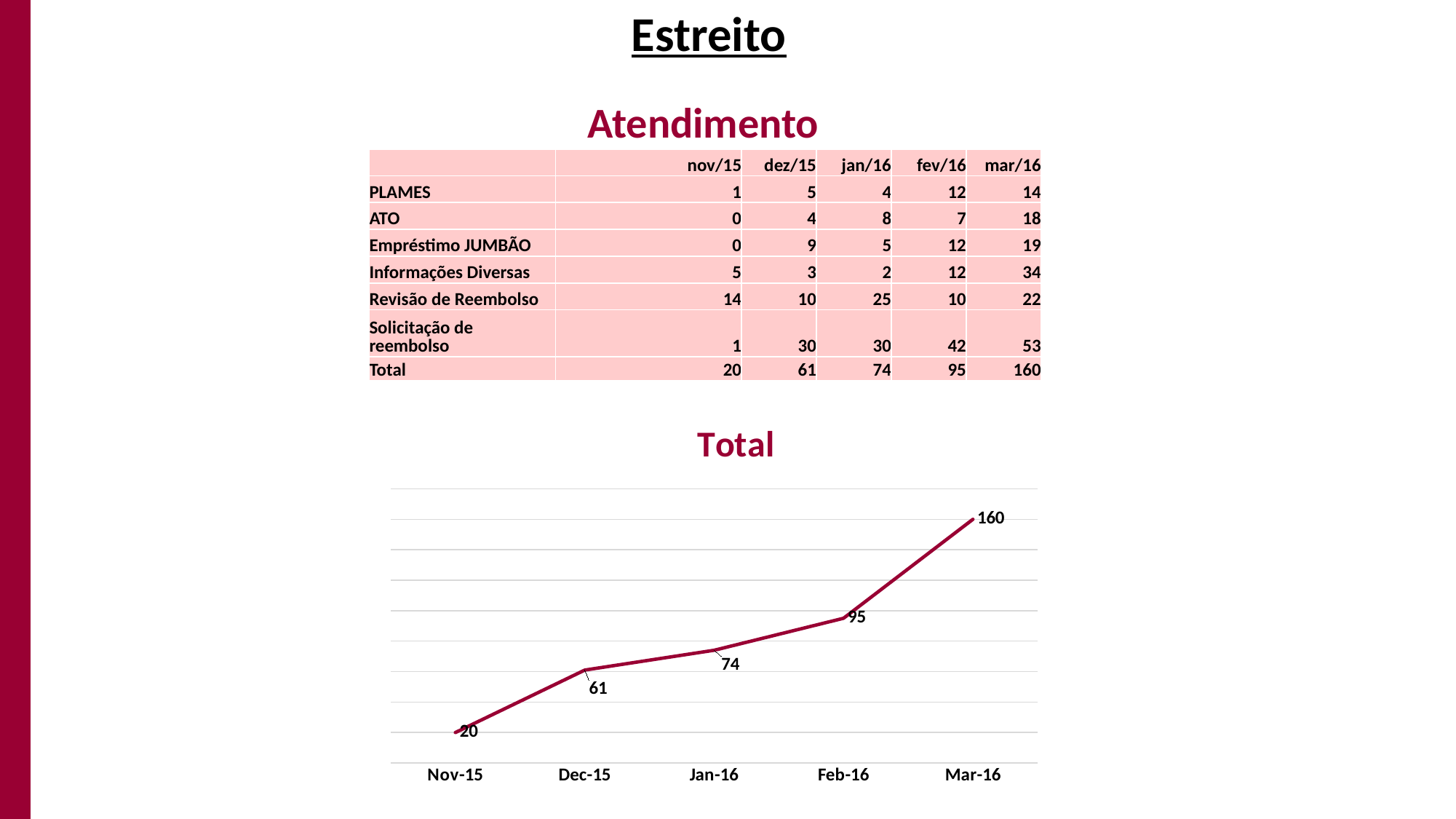
Do the values in the Total chart rise or fall from Nov-15 to Mar-16? rise Which is larger in the Total chart, the value for Feb-16 or the value for Jan-16? Feb-16 What is the value for Mar-16 in the Total chart? 160 What kind of chart is the Total chart? line chart How many data points are plotted in the Total chart? 5 What is the difference between the Dec-15 and Nov-15 values in the Total chart? 41 Which month has the lowest value in the Total chart? Nov-15 What is the value for Jan-16 in the Total chart? 74 What is the value for Nov-15 in the Total chart? 20 Which month has the highest value in the Total chart? Mar-16 What is the difference between the Mar-16 and Feb-16 values in the Total chart? 65 What is the title of the chart on the slide? Total